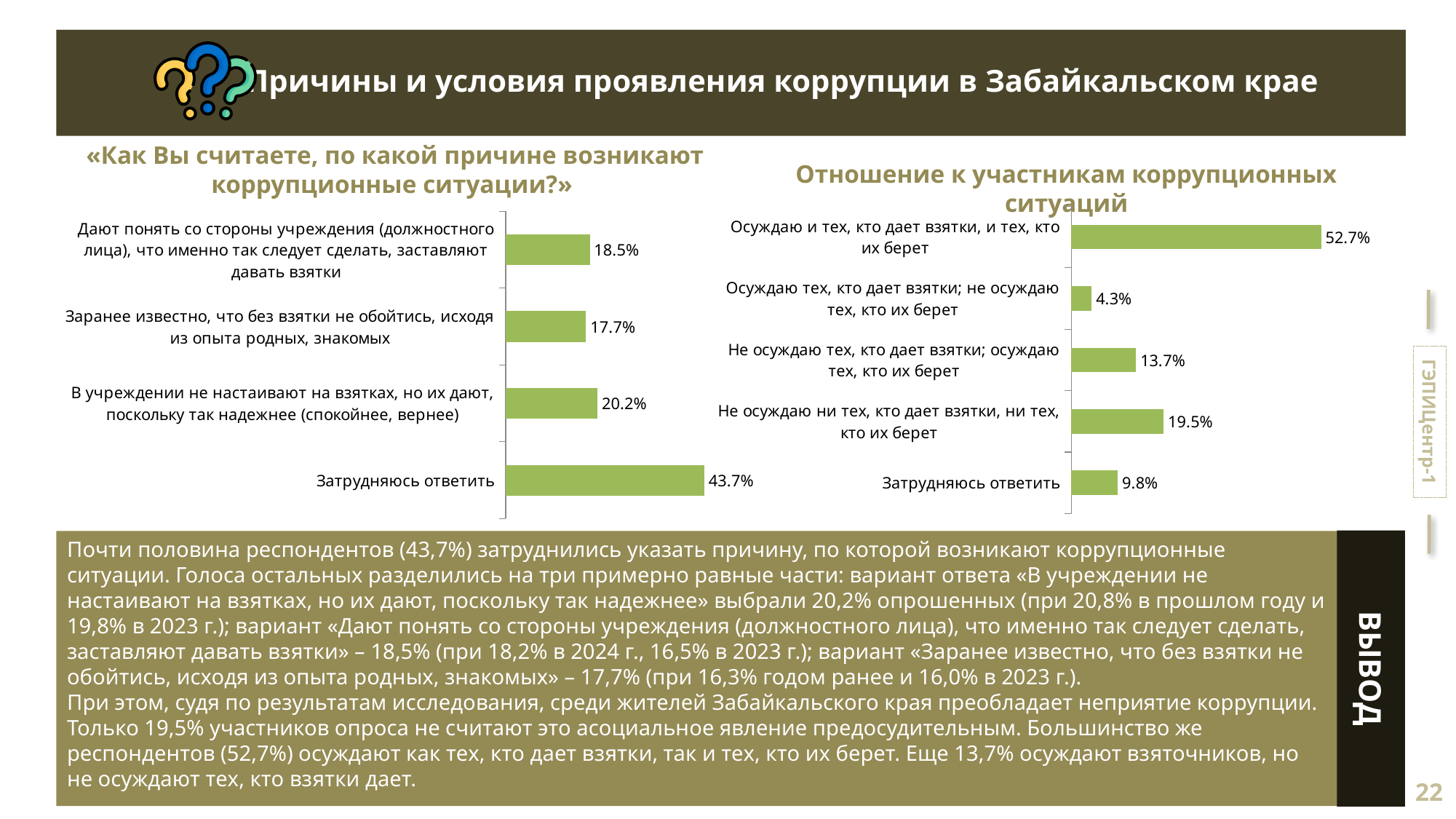
На правой диаграмме «Отношение к участникам коррупционных ситуаций» какое значение у варианта «Не осуждаю тех, кто дает взятки; осуждаю тех, кто их берет»? 13.7% На правой диаграмме «Отношение к участникам коррупционных ситуаций» какой вариант ответа имеет наименьшее значение? Осуждаю тех, кто дает взятки; не осуждаю тех, кто их берет Сколько вариантов ответа показано на левой диаграмме «Как Вы считаете, по какой причине возникают коррупционные ситуации?»? 4 На левой диаграмме «Как Вы считаете, по какой причине возникают коррупционные ситуации?» на сколько процентных пунктов значение «В учреждении не настаивают на взятках, но их дают, поскольку так надежнее» больше значения «Дают понять со стороны учреждения (должностного лица), что именно так следует сделать, заставляют давать взятки»? 1.7 На левой диаграмме «Как Вы считаете, по какой причине возникают коррупционные ситуации?» какой вариант ответа имеет наименьшее значение? Заранее известно, что без взятки не обойтись, исходя из опыта родных, знакомых На левой диаграмме «Как Вы считаете, по какой причине возникают коррупционные ситуации?» какое значение у варианта «Затрудняюсь ответить»? 43.7% На левой диаграмме «Как Вы считаете, по какой причине возникают коррупционные ситуации?» какое значение у варианта «Заранее известно, что без взятки не обойтись, исходя из опыта родных, знакомых»? 17.7% На левой диаграмме «Как Вы считаете, по какой причине возникают коррупционные ситуации?» какой вариант ответа имеет наибольшее значение? Затрудняюсь ответить Какого типа диаграмма «Отношение к участникам коррупционных ситуаций»? Столбчатая (bar chart) Сколько вариантов ответа показано на правой диаграмме «Отношение к участникам коррупционных ситуаций»? 5 На правой диаграмме «Отношение к участникам коррупционных ситуаций» какое значение у варианта «Осуждаю и тех, кто дает взятки, и тех, кто их берет»? 52.7% На правой диаграмме «Отношение к участникам коррупционных ситуаций» что больше: значение «Не осуждаю ни тех, кто дает взятки, ни тех, кто их берет» или значение «Затрудняюсь ответить»? Не осуждаю ни тех, кто дает взятки, ни тех, кто их берет